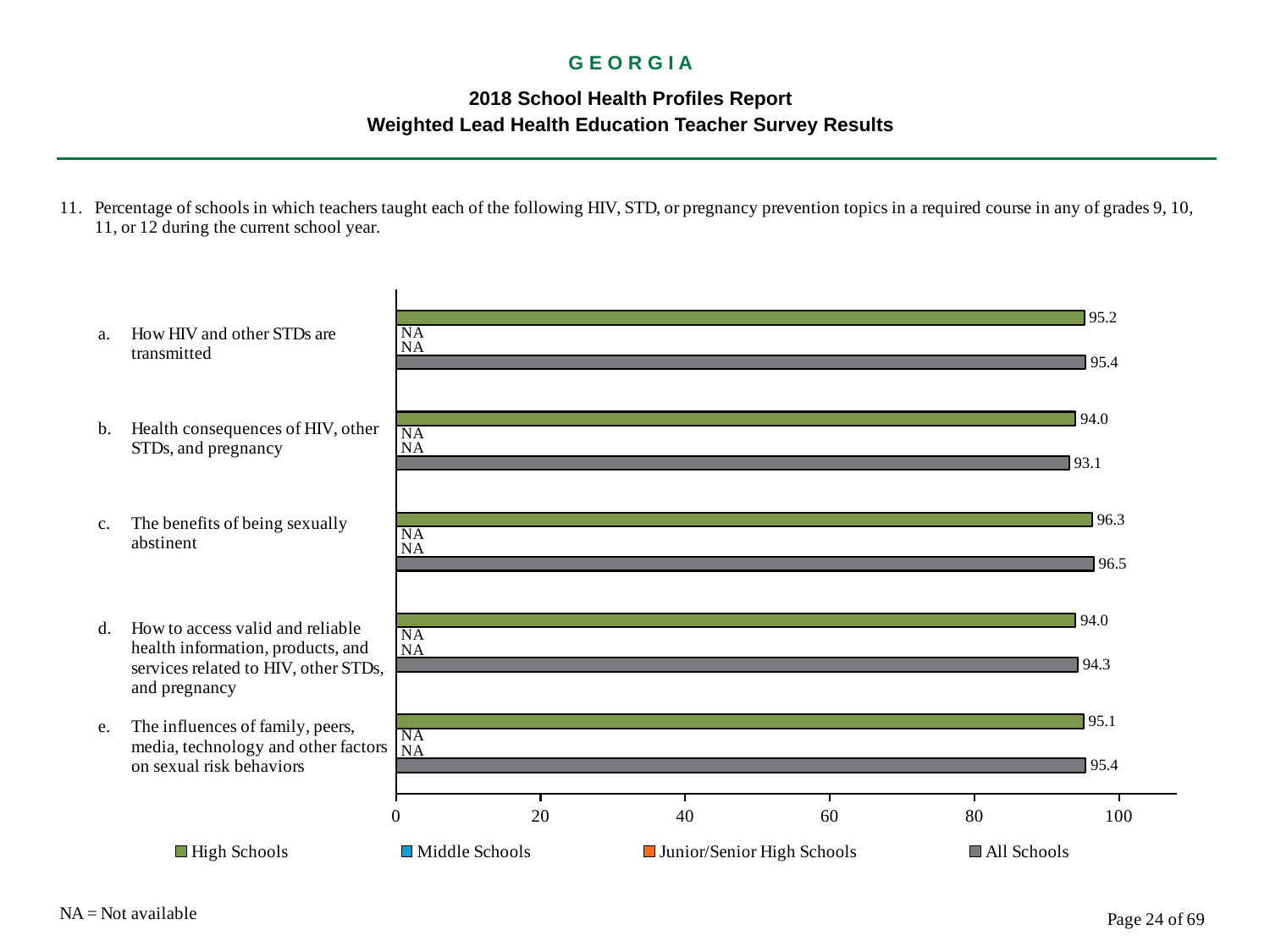
What kind of chart is shown on the slide? Bar chart Which topic has the highest High Schools value? The benefits of being sexually abstinent What is the difference between the All Schools and High Schools values for 'Health consequences of HIV, other STDs, and pregnancy'? 0.9 How many topics are listed on the chart? 5 What value is shown for Middle Schools for 'The benefits of being sexually abstinent'? NA What is the High Schools value for 'The influences of family, peers, media, technology and other factors on sexual risk behaviors'? 95.1 For 'How to access valid and reliable health information, products, and services related to HIV, other STDs, and pregnancy', which is larger: the High Schools value or the All Schools value? All Schools What is the High Schools value for 'How HIV and other STDs are transmitted'? 95.2 Which topic has the lowest All Schools value? Health consequences of HIV, other STDs, and pregnancy What is the All Schools value for 'The benefits of being sexually abstinent'? 96.5 What is the All Schools value for 'Health consequences of HIV, other STDs, and pregnancy'? 93.1 How many series does the legend list? 4